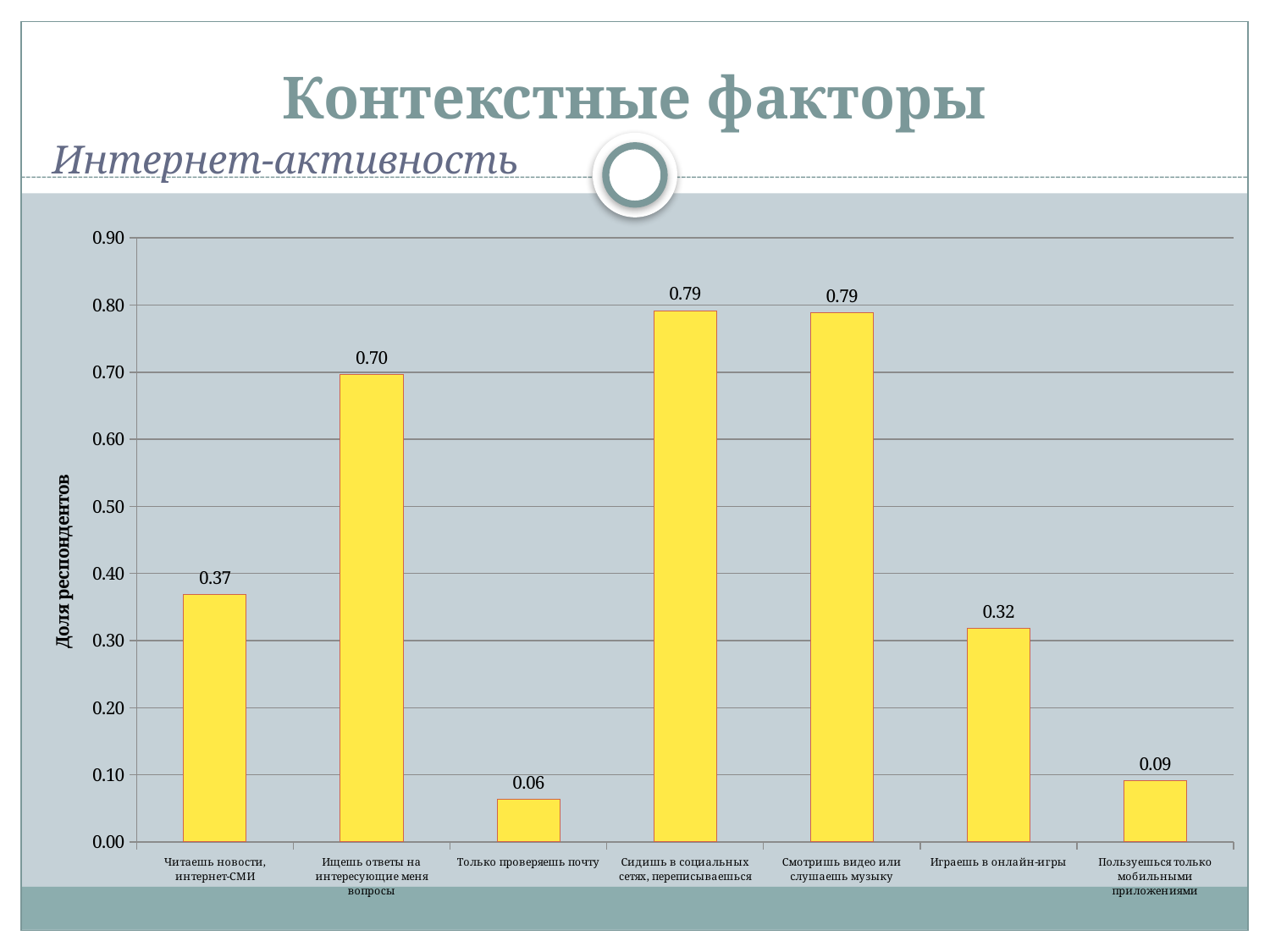
Is the value for "Сидишь в социальных сетях, переписываешься" greater or less than 0.70? greater What kind of chart is shown on the slide? bar chart What is the value for "Ищешь ответы на интересующие меня вопросы"? 0.70 What is the value for "Читаешь новости, интернет-СМИ"? 0.37 What is the difference between the values for "Ищешь ответы на интересующие меня вопросы" and "Читаешь новости, интернет-СМИ"? 0.33 What is the highest value shown on the chart? 0.79 How many categories are shown on the chart? 7 Which category has the lowest value? Только проверяешь почту What is the value for "Пользуешься только мобильными приложениями"? 0.09 Which is larger: the value for "Играешь в онлайн-игры" or the value for "Читаешь новости, интернет-СМИ"? Читаешь новости, интернет-СМИ What is the label of the vertical axis? Доля респондентов What is the value for "Играешь в онлайн-игры"? 0.32